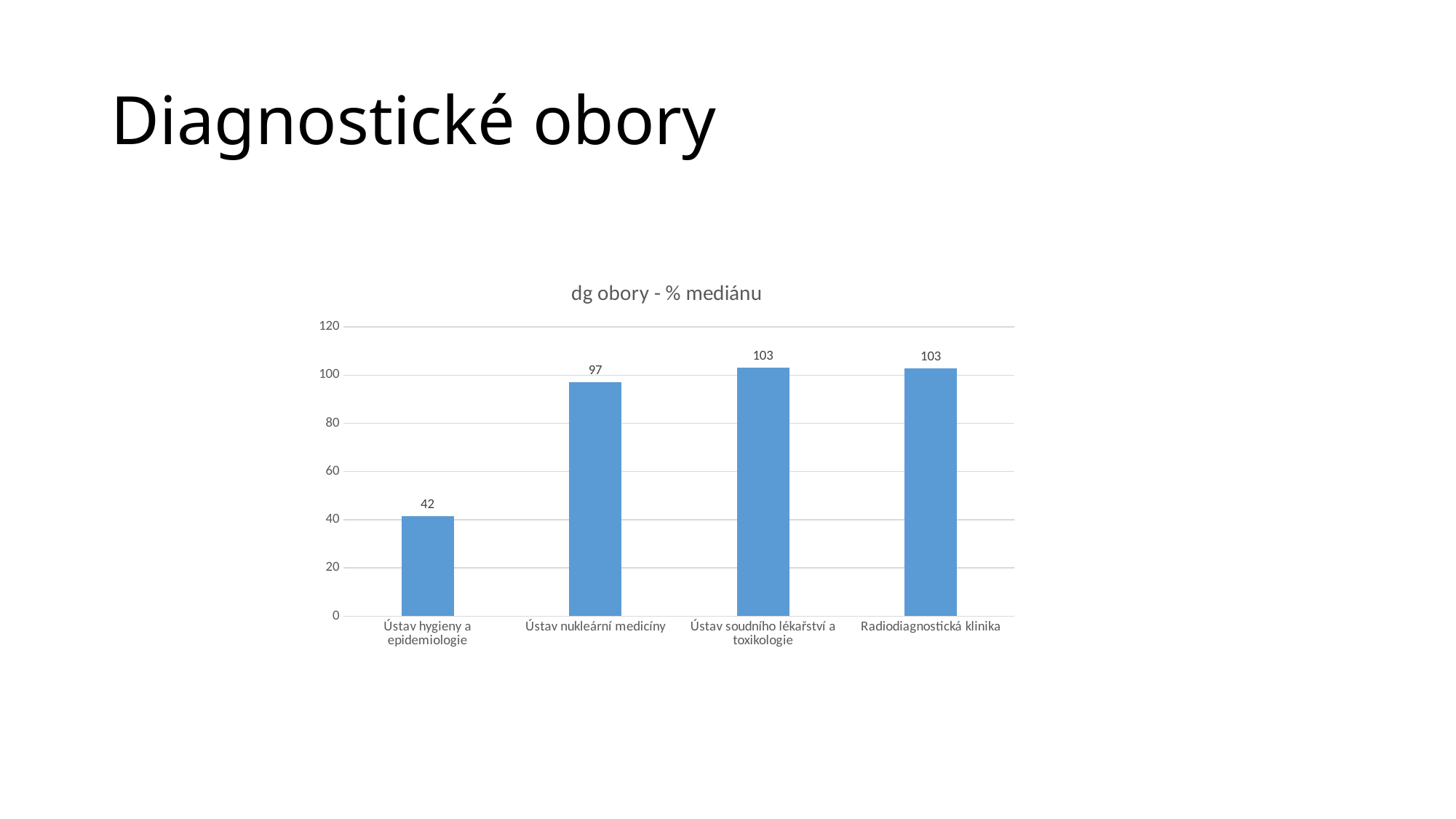
What is the value for Ústav nukleární medicíny? 97 Is the value for Ústav nukleární medicíny greater or less than 100? less What is the value for Radiodiagnostická klinika? 103 How many categories are shown in the chart? 4 What is the value for Ústav hygieny a epidemiologie? 42 What is the difference between the values for Ústav soudního lékařství a toxikologie and Ústav nukleární medicíny? 6 Which category has the lowest value? Ústav hygieny a epidemiologie Which is larger, the value for Ústav nukleární medicíny or the value for Ústav hygieny a epidemiologie? Ústav nukleární medicíny What is the difference between the values for Ústav nukleární medicíny and Ústav hygieny a epidemiologie? 55 What is the highest value shown on the vertical axis? 120 What is the title of the chart? dg obory - % mediánu What kind of chart is shown on the slide? bar chart